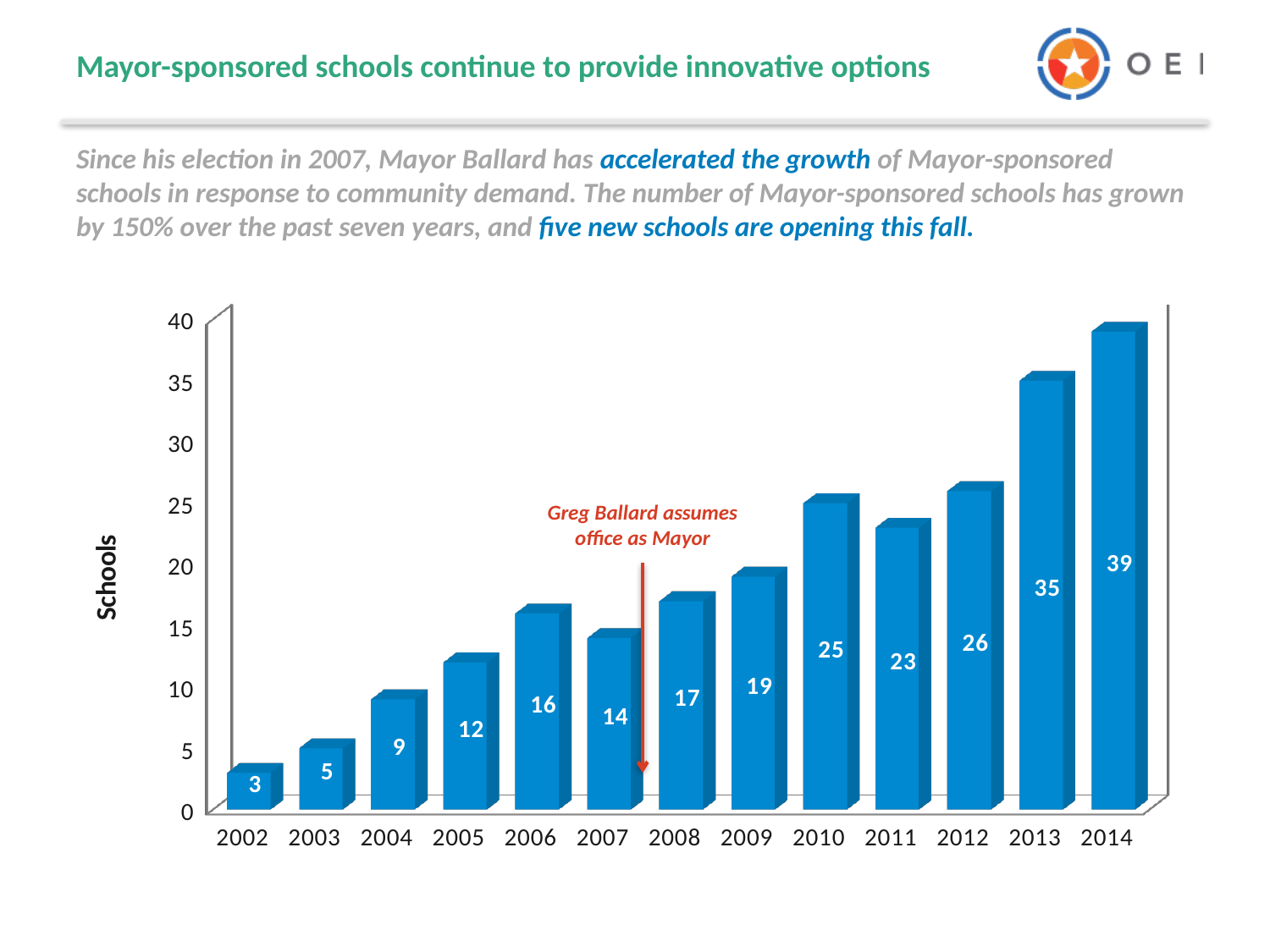
Is the value for 2013 greater or less than 30? greater What is the difference between the number of schools in 2014 and in 2007? 25 Which year has the highest number of schools? 2014 How many years are shown on the x axis? 13 What kind of chart is shown on the slide? Bar chart Which year has more schools, 2006 or 2007? 2006 Which year has the lowest number of schools? 2002 Do the values generally rise or fall from 2002 to 2014? Rise How many Mayor-sponsored schools were there in 2010? 25 What is the value shown for 2007? 14 What event does the red arrow annotation on the chart mark? Greg Ballard assumes office as Mayor What is the label on the vertical axis? Schools